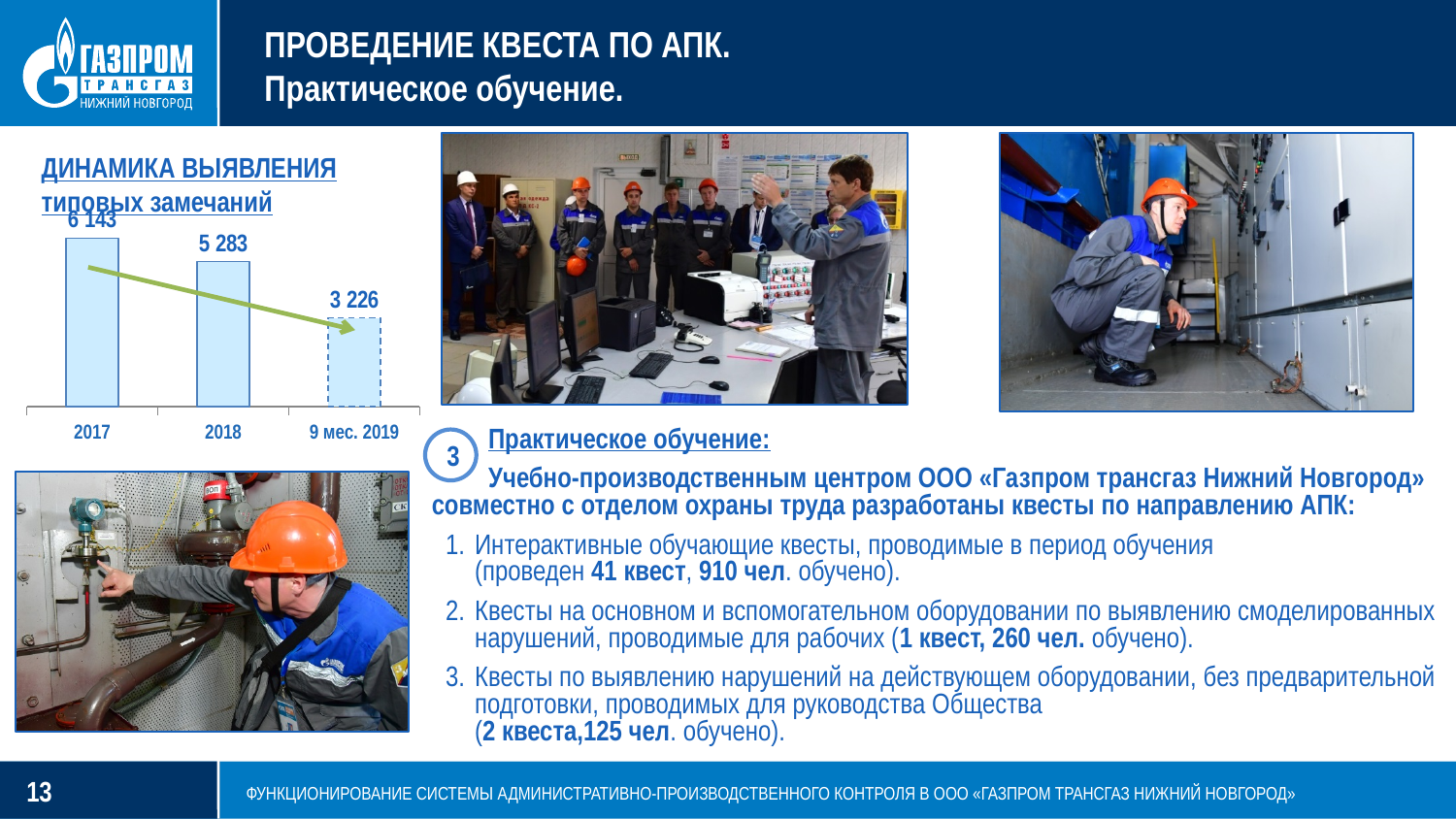
What is the difference between the values for 2018 and 9 мес. 2019? 2 057 What kind of chart is shown on the slide? bar chart What is the value for 2018 in the chart? 5 283 What is the title of the chart? ДИНАМИКА ВЫЯВЛЕНИЯ типовых замечаний What is the value for 2017 in the chart? 6 143 Which is larger, the value for 2018 or the value for 9 мес. 2019? 2018 Which category has the lowest value in the chart? 9 мес. 2019 How many categories are shown in the chart? 3 Which category has the highest value in the chart? 2017 What is the value for 9 мес. 2019 in the chart? 3 226 What is the difference between the values for 2017 and 2018? 860 Do the values rise or fall from 2017 to 9 мес. 2019? fall